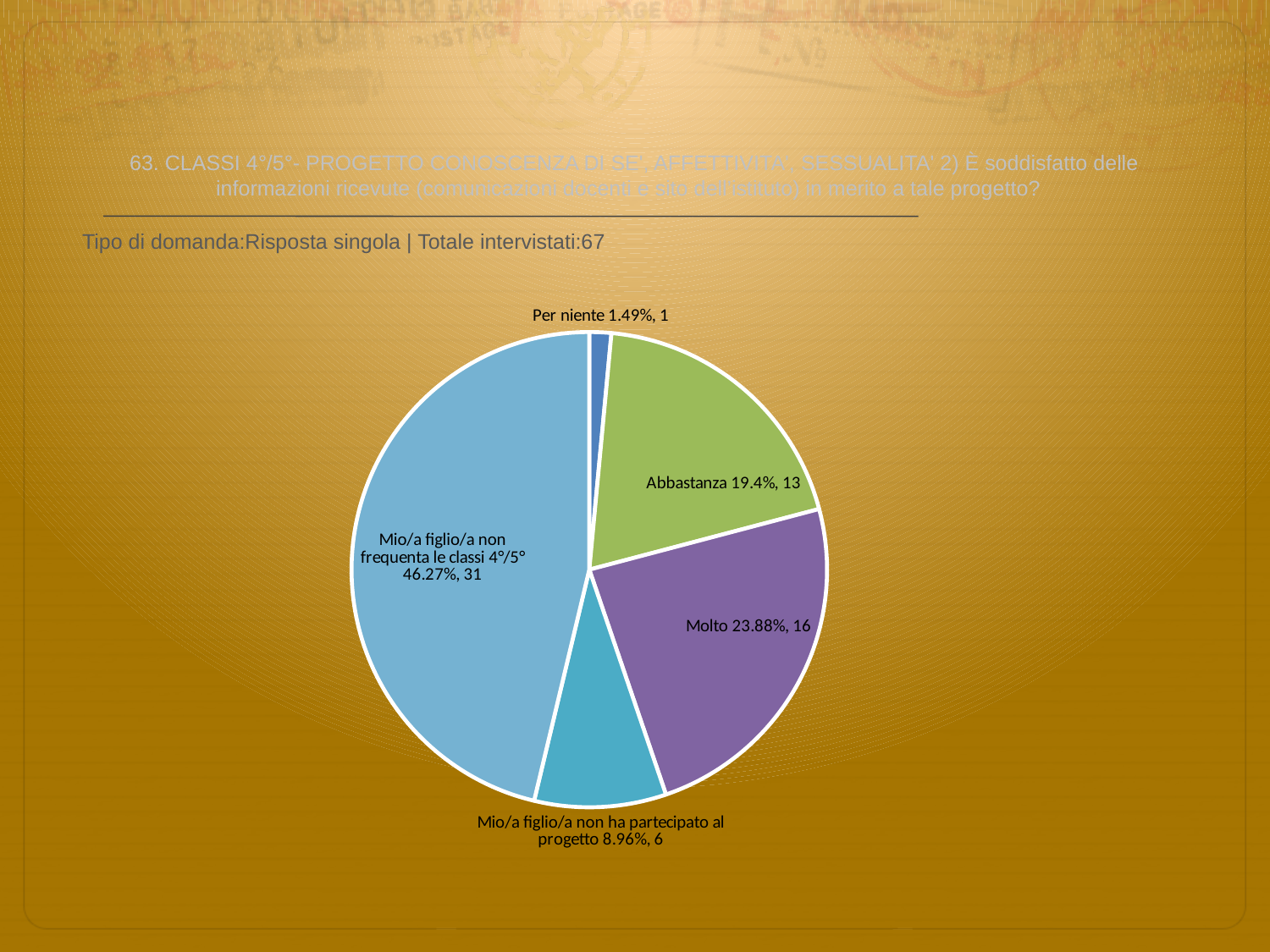
Which category has the largest slice of the pie? Mio/a figlio/a non frequenta le classi 4°/5° What is the count for 'Per niente'? 1 How many respondents answered 'Abbastanza'? 13 What percentage share does the 'Molto' slice have? 23.88% What colour is the 'Molto' slice? purple Which has a larger count, 'Mio/a figlio/a non ha partecipato al progetto' or 'Abbastanza'? Abbastanza What kind of chart is shown on the slide? pie chart Which category has the smallest slice of the pie? Per niente What percentage share does 'Mio/a figlio/a non ha partecipato al progetto' have? 8.96% How many slices does the pie chart have? 5 What is the total number of respondents (Totale intervistati) stated on the slide? 67 What is the difference in count between 'Molto' and 'Abbastanza'? 3